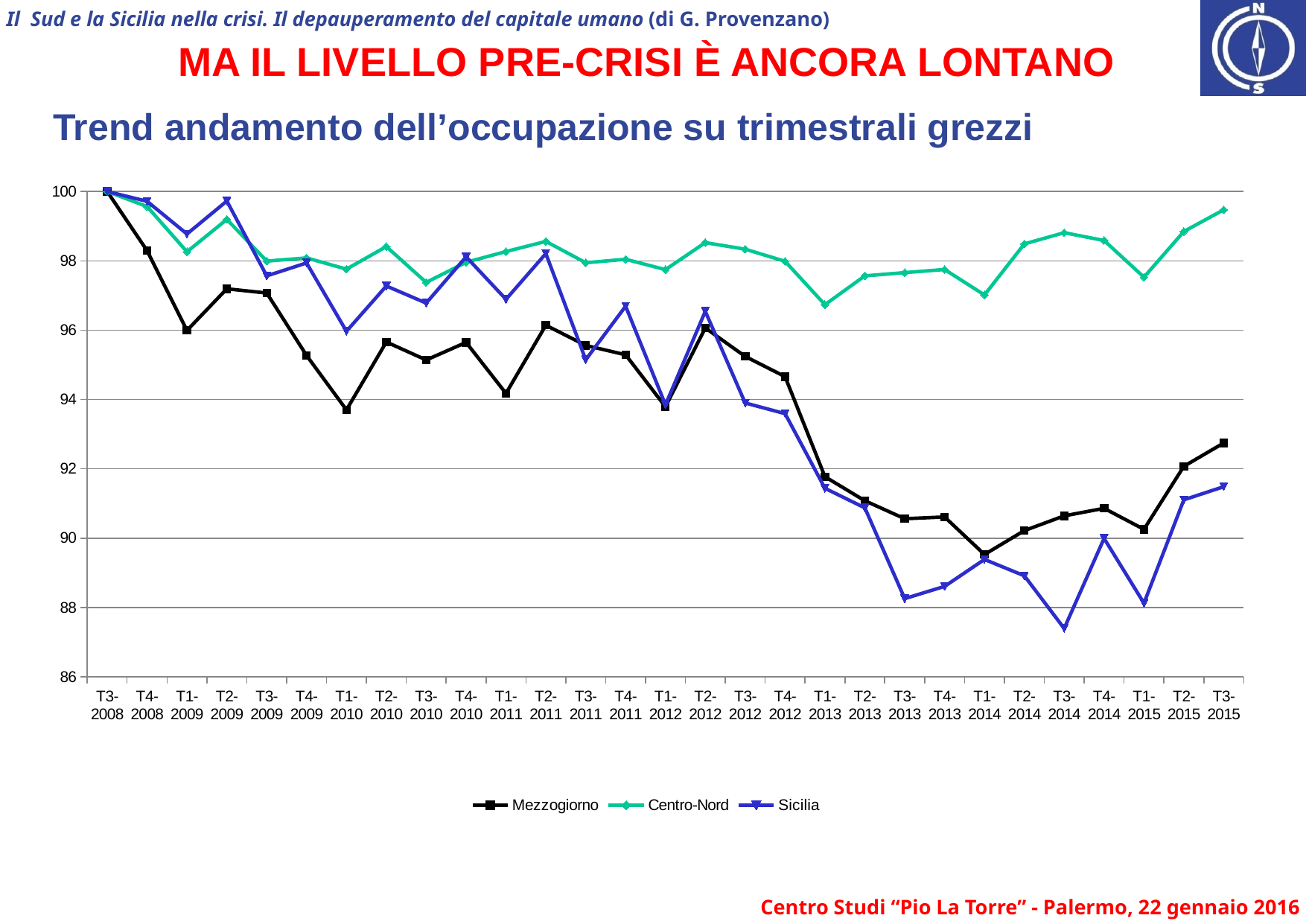
Which series is shown in black with square markers? Mezzogiorno Does the Mezzogiorno series rise or fall overall from T3-2008 to T3-2013? fall How many quarters are plotted along the x axis? 29 What is the value of all three series at T3-2008? 100 Is the value for Centro-Nord at T1-2013 greater or less than 98? less What kind of chart is shown on the slide? line chart In which quarter does the Sicilia series reach its lowest value? T3-2014 Is the value for Mezzogiorno at T1-2014 greater or less than 90? less Is the value for Sicilia at T3-2014 greater or less than 88? less At T3-2015, which is higher: Centro-Nord or Sicilia? Centro-Nord At T3-2014, which is higher: Mezzogiorno or Sicilia? Mezzogiorno How many series does the legend list? 3